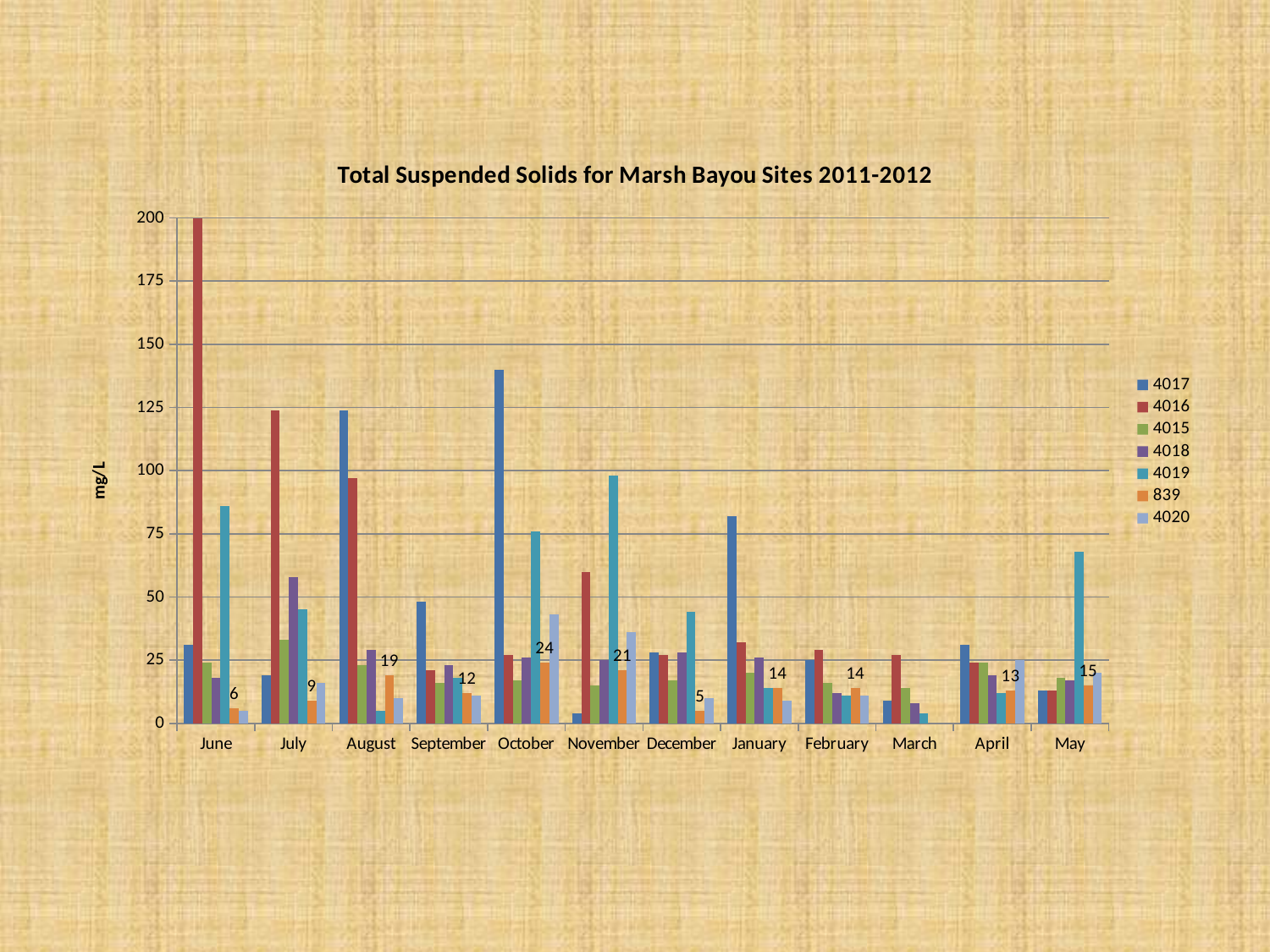
What is the value for site 839 in October? 24 What is the value for site 839 in August? 19 What is the value for site 839 in June? 6 In June, which is larger: the value for site 4016 or the value for site 4017? 4016 Is the value for site 4016 in June greater or less than 175? greater Among the labelled values for site 839, which month has the lowest value? December What is the difference between the site 839 values for October and December? 19 What unit is shown on the y-axis label? mg/L How many series does the legend list? 7 Is the value for site 4019 in November greater or less than 75? greater What is the value for site 839 in December? 5 Among the labelled values for site 839, which month has the highest value? October